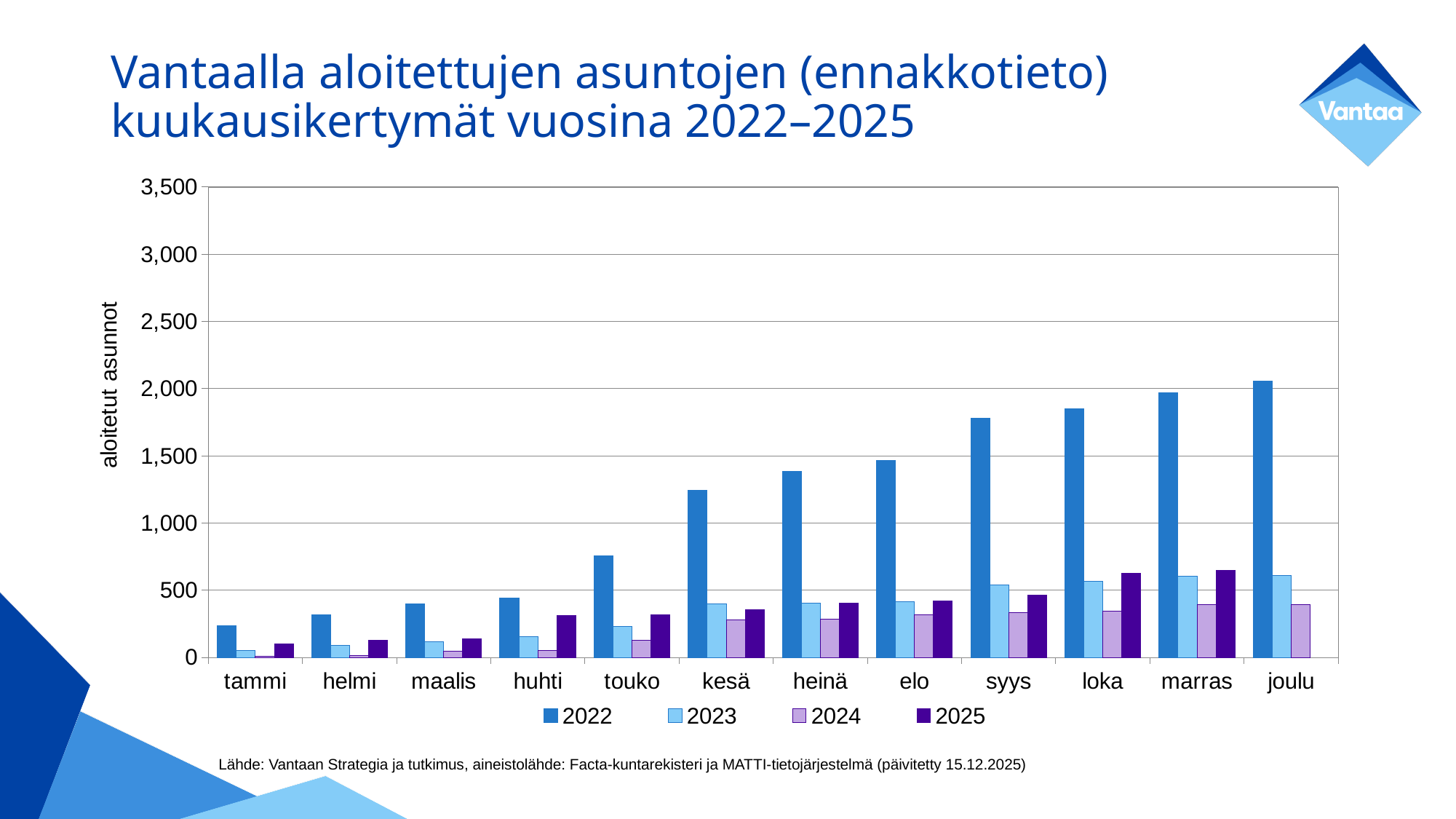
How many series does the legend list? 4 In which month is the 2022 value lowest? tammi What kind of chart is shown on the slide? bar chart Do the 2022 values rise or fall from tammi to joulu? rise For kesä, which series has the larger value: 2022 or 2023? 2022 For loka, which series has the larger value: 2023 or 2025? 2025 In which month is the 2022 value highest? joulu Is the 2022 value for syys greater or less than 1,500? greater How many months (categories) are shown on the x axis? 12 What is the label of the y axis? aloitetut asunnot Is the 2022 value for touko greater or less than 1,000? less Is the 2023 value for joulu greater or less than 1,000? less